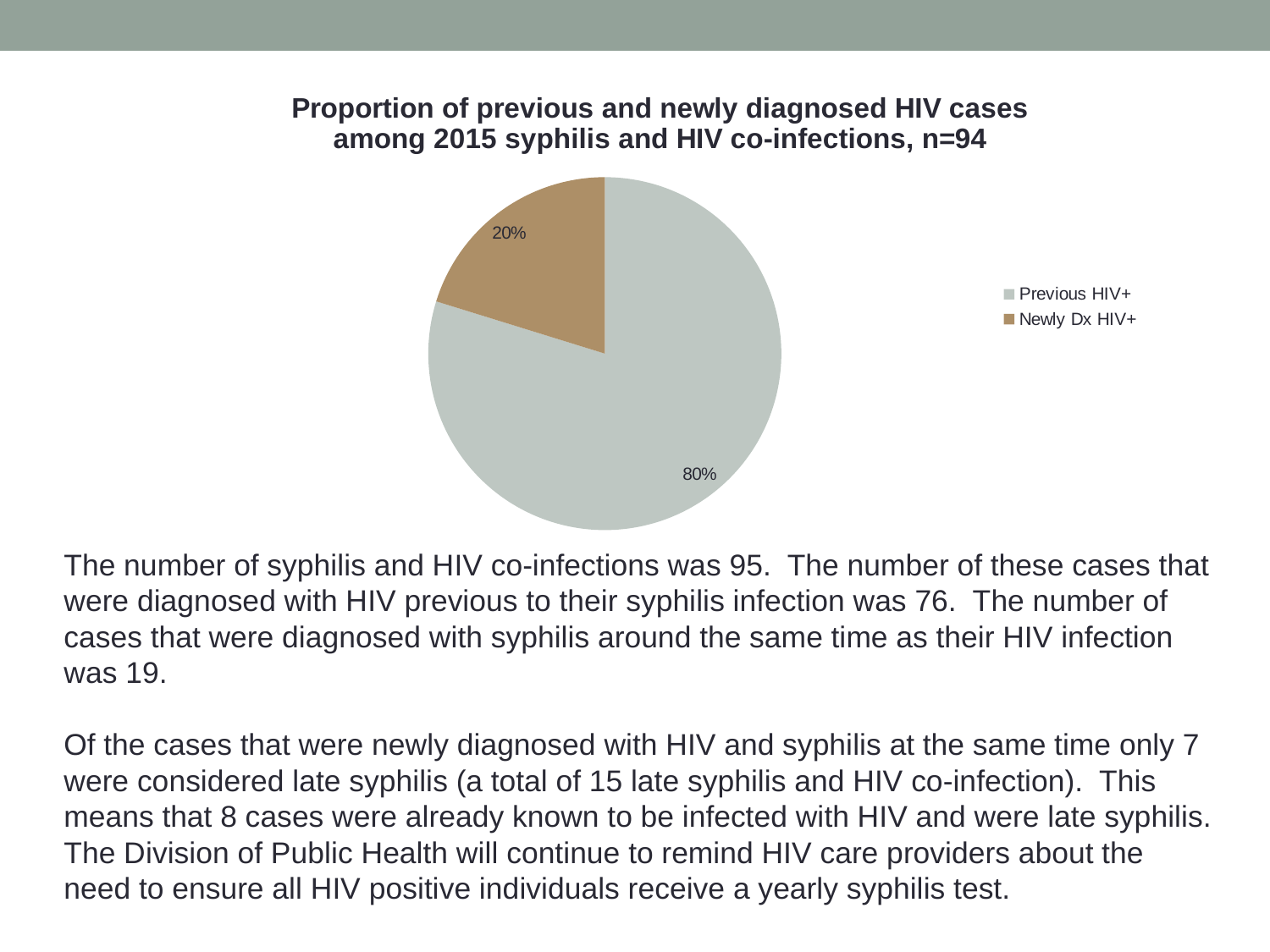
What percentage of the pie is labelled for Newly Dx HIV+? 20% How many entries does the legend list? 2 Which category has the largest share of the pie? Previous HIV+ What type of chart is shown on the slide? Pie chart Which category has the smallest share of the pie? Newly Dx HIV+ How many slices does the pie chart have? 2 What is the title of the chart? Proportion of previous and newly diagnosed HIV cases among 2015 syphilis and HIV co-infections, n=94 What colour is the Newly Dx HIV+ slice? Brown What is the difference in percentage points between the Previous HIV+ and Newly Dx HIV+ slices? 60 What percentage of the pie is labelled for Previous HIV+? 80% Which slice is larger, Previous HIV+ or Newly Dx HIV+? Previous HIV+ What share of the pie does the Newly Dx HIV+ slice represent? 20%